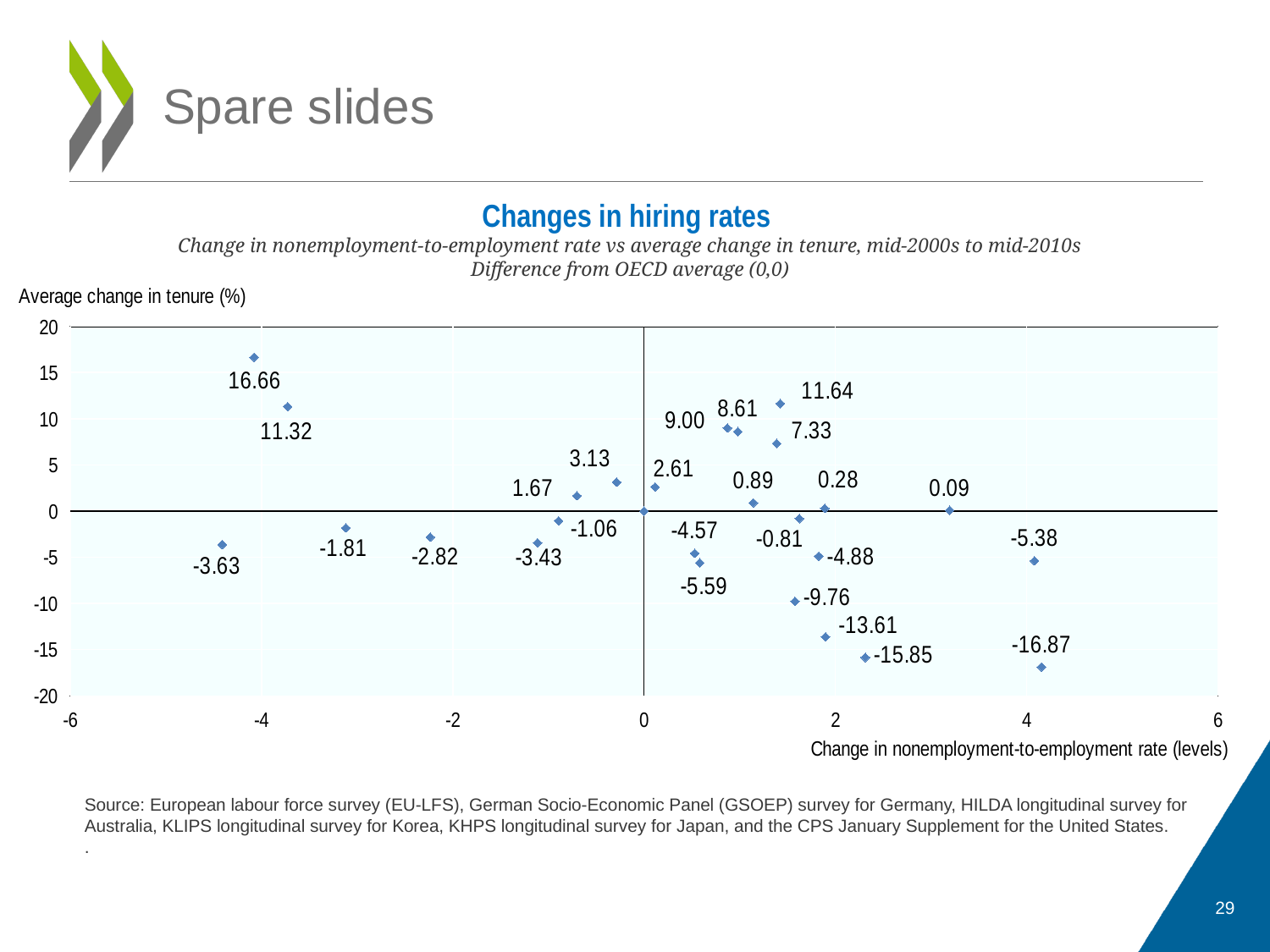
What is the difference between the highest labeled value (16.66) and the lowest labeled value (-16.87) on the chart? 33.53 What is the label of the horizontal axis of the chart? Change in nonemployment-to-employment rate (levels) Which is larger, the point labeled 11.64 or the point labeled 11.32? 11.64 Is the horizontal-axis value of the point labeled -9.76 greater or less than 0? greater What is the difference between the points labeled 9.00 and 8.61? 0.39 Is the horizontal-axis value of the point labeled 0.09 greater or less than 2? greater Which is larger, the point labeled -5.59 or the point labeled -4.57? -4.57 What is the highest data label value shown on the chart? 16.66 What is the lowest data label value shown on the chart? -16.87 What is the title of the chart? Changes in hiring rates What kind of chart is shown on the slide? Scatter chart Is the horizontal-axis value of the point labeled -3.63 greater or less than -4? less